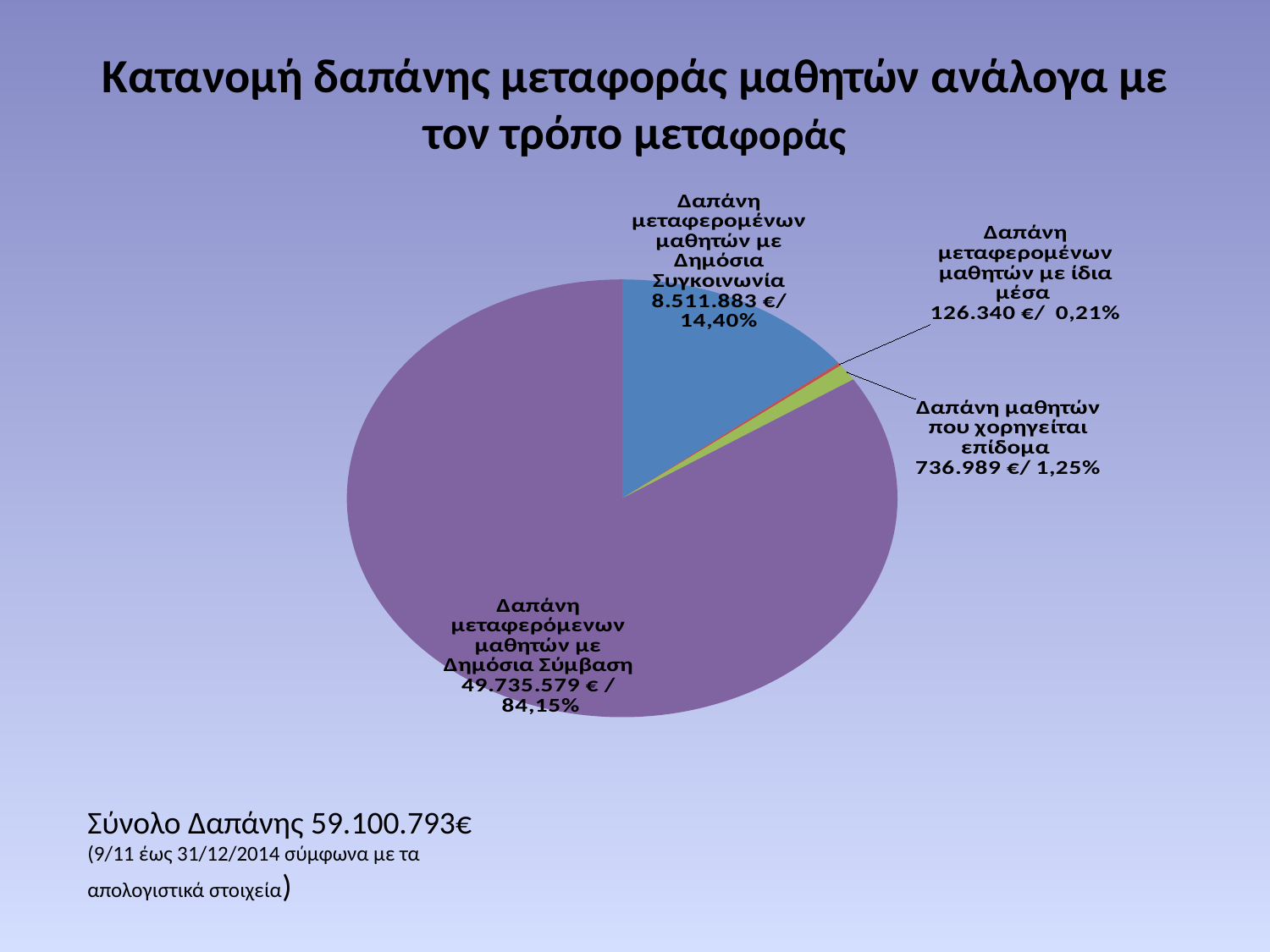
What is the expense value for "Δαπάνη μεταφερόμενων μαθητών με Δημόσια Σύμβαση"? 49.735.579 € What is the expense value for "Δαπάνη μεταφερομένων μαθητών με Δημόσια Συγκοινωνία"? 8.511.883 € What total expense (Σύνολο Δαπάνης) is stated on the slide? 59.100.793€ What kind of chart is shown on the slide? pie chart Which category has the largest share of the pie? Δαπάνη μεταφερόμενων μαθητών με Δημόσια Σύμβαση Which is larger: the expense for "Δημόσια Συγκοινωνία" or the expense for "επίδομα"? Δημόσια Συγκοινωνία What is the expense value for "Δαπάνη μεταφερομένων μαθητών με ίδια μέσα"? 126.340 € How many slices does the pie chart have? 4 What is the difference in percentage share between "Δημόσια Σύμβαση" (84,15%) and "Δημόσια Συγκοινωνία" (14,40%)? 69,75% Which category has the smallest share of the pie? Δαπάνη μεταφερομένων μαθητών με ίδια μέσα What percentage share does "Δαπάνη μεταφερομένων μαθητών με Δημόσια Συγκοινωνία" have? 14,40% What percentage share does "Δαπάνη μαθητών που χορηγείται επίδομα" have? 1,25%